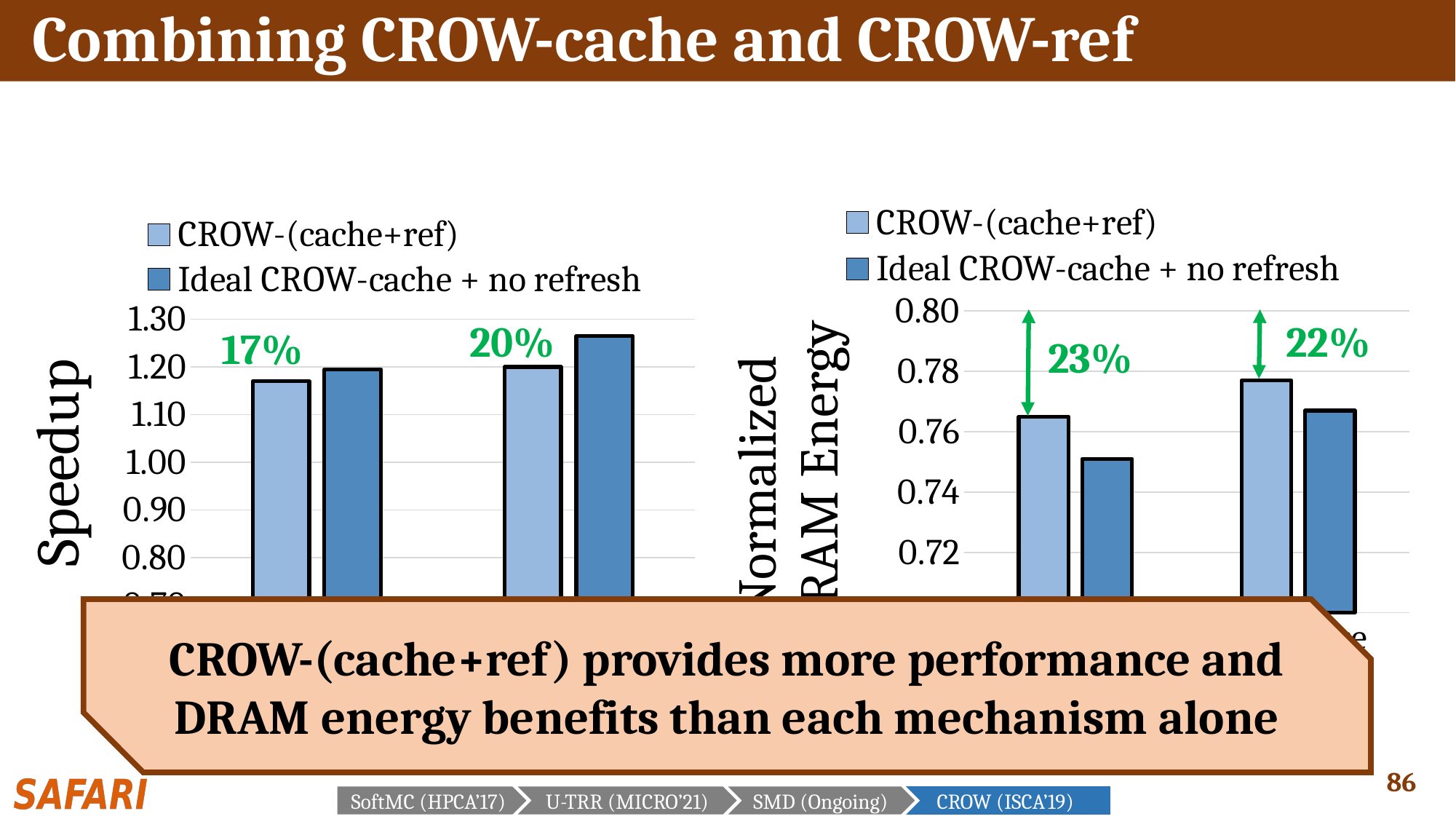
In the Normalized DRAM Energy chart, what percentage is annotated next to the right group of bars? 22% In the Normalized DRAM Energy chart, what percentage is annotated next to the left group of bars? 23% How many series does the legend of the Speedup chart list? 2 In the Speedup chart, is the CROW-(cache+ref) value in the left group of bars greater or less than 1.10? greater What kind of chart is the Speedup chart on the left of the slide? bar chart In the Speedup chart, is the Ideal CROW-cache + no refresh value in the right group of bars greater or less than 1.20? greater What is the y-axis label of the chart on the left of the slide? Speedup In the Normalized DRAM Energy chart, is the Ideal CROW-cache + no refresh value in the left group of bars greater or less than 0.76? less In the Normalized DRAM Energy chart, in the left group of bars, which series has the higher value: CROW-(cache+ref) or Ideal CROW-cache + no refresh? CROW-(cache+ref) In the Speedup chart, what percentage is annotated above the right group of bars? 20% In the Speedup chart, what percentage is annotated above the left group of bars? 17% In the Speedup chart, in the right group of bars, which series has the higher value: CROW-(cache+ref) or Ideal CROW-cache + no refresh? Ideal CROW-cache + no refresh